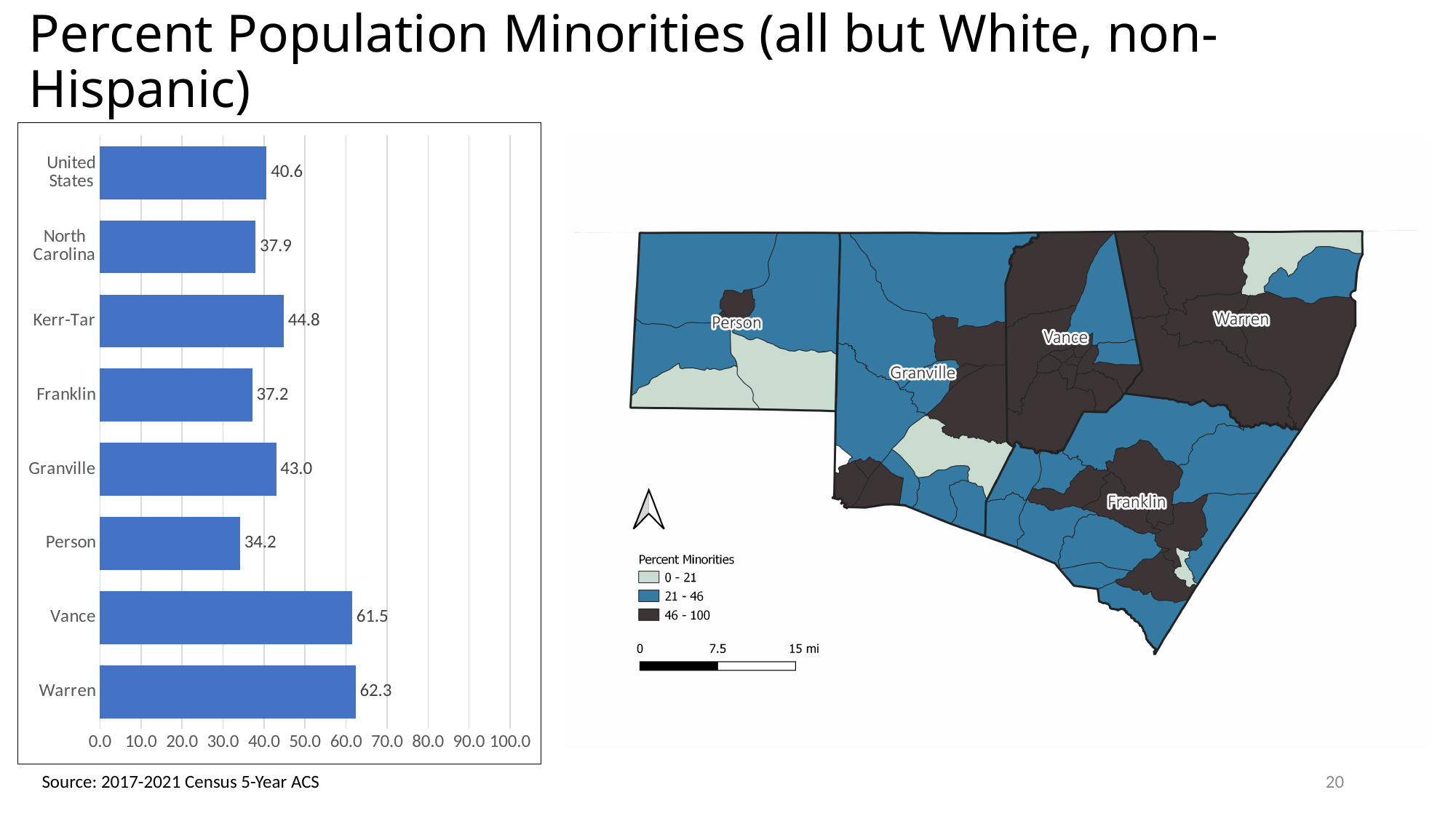
What is the value for Warren in the bar chart? 62.3 Is the value for Franklin in the bar chart greater or less than 40.0? less What is the value for Person in the bar chart? 34.2 What kind of chart is shown on the left of the slide? bar chart Which category has the lowest value in the bar chart? Person What is the difference between the values for Vance and Granville in the bar chart? 18.5 Which is larger in the bar chart, the value for United States or the value for North Carolina? United States How many categories are shown in the bar chart? 8 What is the value for Kerr-Tar in the bar chart? 44.8 Which category has the highest value in the bar chart? Warren What is the source cited below the bar chart? 2017-2021 Census 5-Year ACS What is the difference between the values for Warren and United States in the bar chart? 21.7